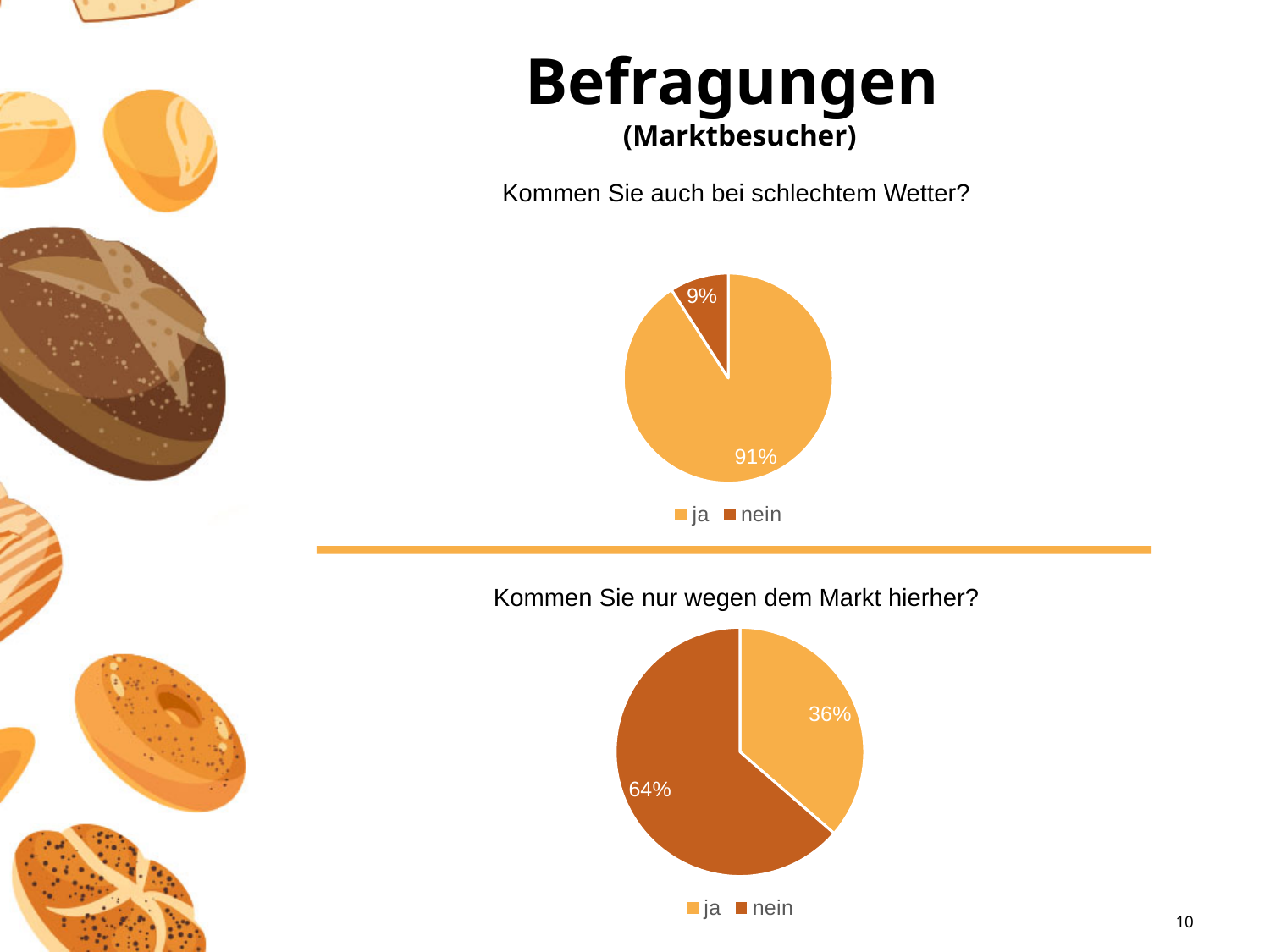
In the chart 'Kommen Sie nur wegen dem Markt hierher?', what share of respondents answered 'nein'? 64% In the chart 'Kommen Sie nur wegen dem Markt hierher?', which answer has the smallest slice? ja In the chart 'Kommen Sie nur wegen dem Markt hierher?', which is larger, 'ja' or 'nein'? nein How many slices does the chart 'Kommen Sie nur wegen dem Markt hierher?' have? 2 In the chart 'Kommen Sie auch bei schlechtem Wetter?', which answer has the largest slice? ja In the chart 'Kommen Sie nur wegen dem Markt hierher?', what share of respondents answered 'ja'? 36% In the chart 'Kommen Sie auch bei schlechtem Wetter?', what share of respondents answered 'ja'? 91% What type of chart is used for 'Kommen Sie auch bei schlechtem Wetter?'? pie chart In the chart 'Kommen Sie nur wegen dem Markt hierher?', what is the difference in percentage points between 'nein' and 'ja'? 28 What entries does the legend of the chart 'Kommen Sie auch bei schlechtem Wetter?' list? ja, nein In the chart 'Kommen Sie auch bei schlechtem Wetter?', what is the difference in percentage points between 'ja' and 'nein'? 82 In the chart 'Kommen Sie auch bei schlechtem Wetter?', what share of respondents answered 'nein'? 9%